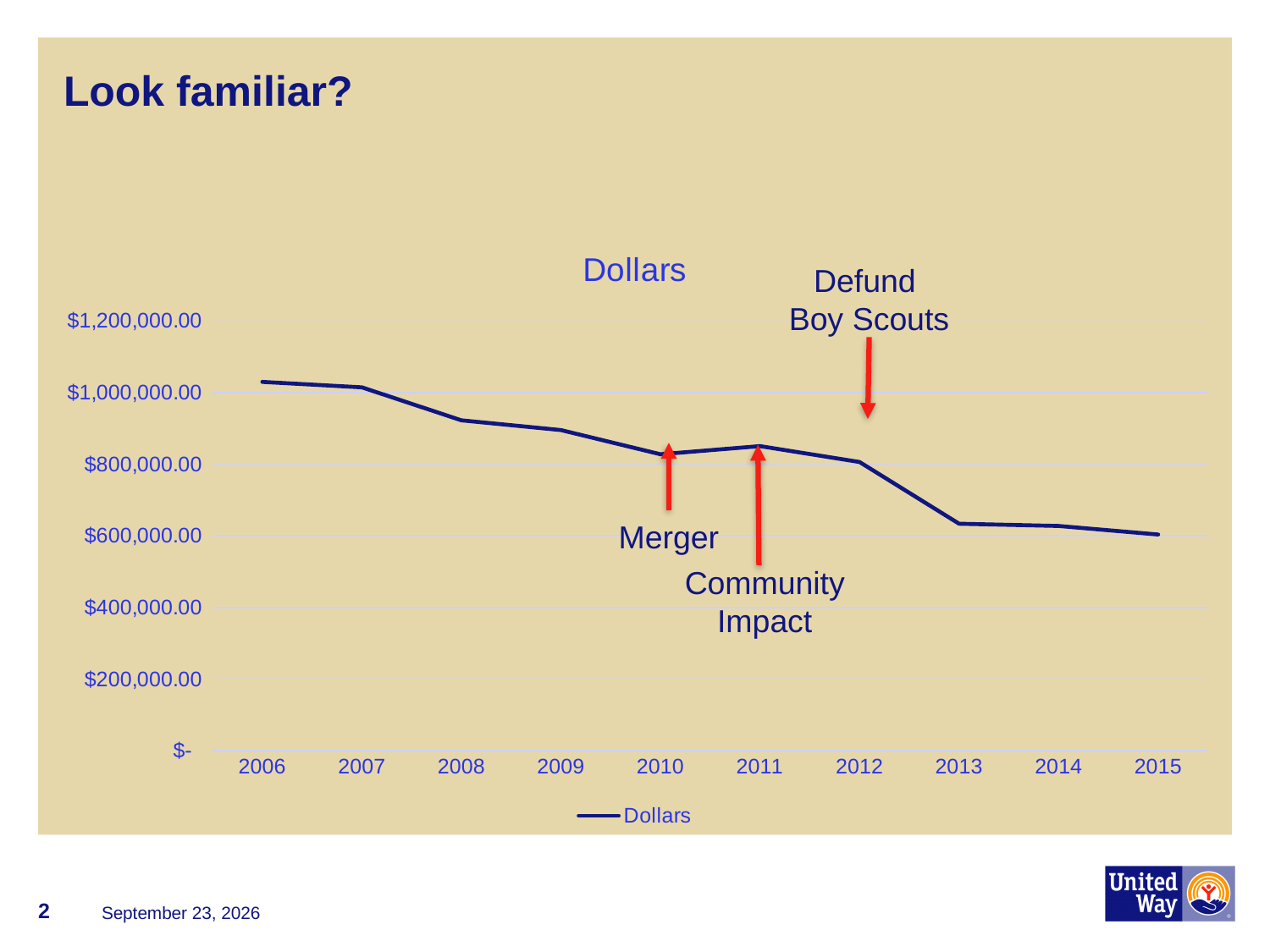
Which year has the lowest value? 2015 Is the value for 2014 greater or less than $800,000.00? less Is the value for 2013 greater or less than $800,000.00? less What is the title of the chart? Dollars Is the value for 2008 greater or less than $1,000,000.00? less Do the values generally rise or fall from 2006 to 2015? fall Which year is annotated with the label "Merger"? 2010 How many years are plotted along the x axis? 10 How many series does the legend list? 1 Which is larger, the value for 2008 or the value for 2013? 2008 What kind of chart is shown on the slide? line chart